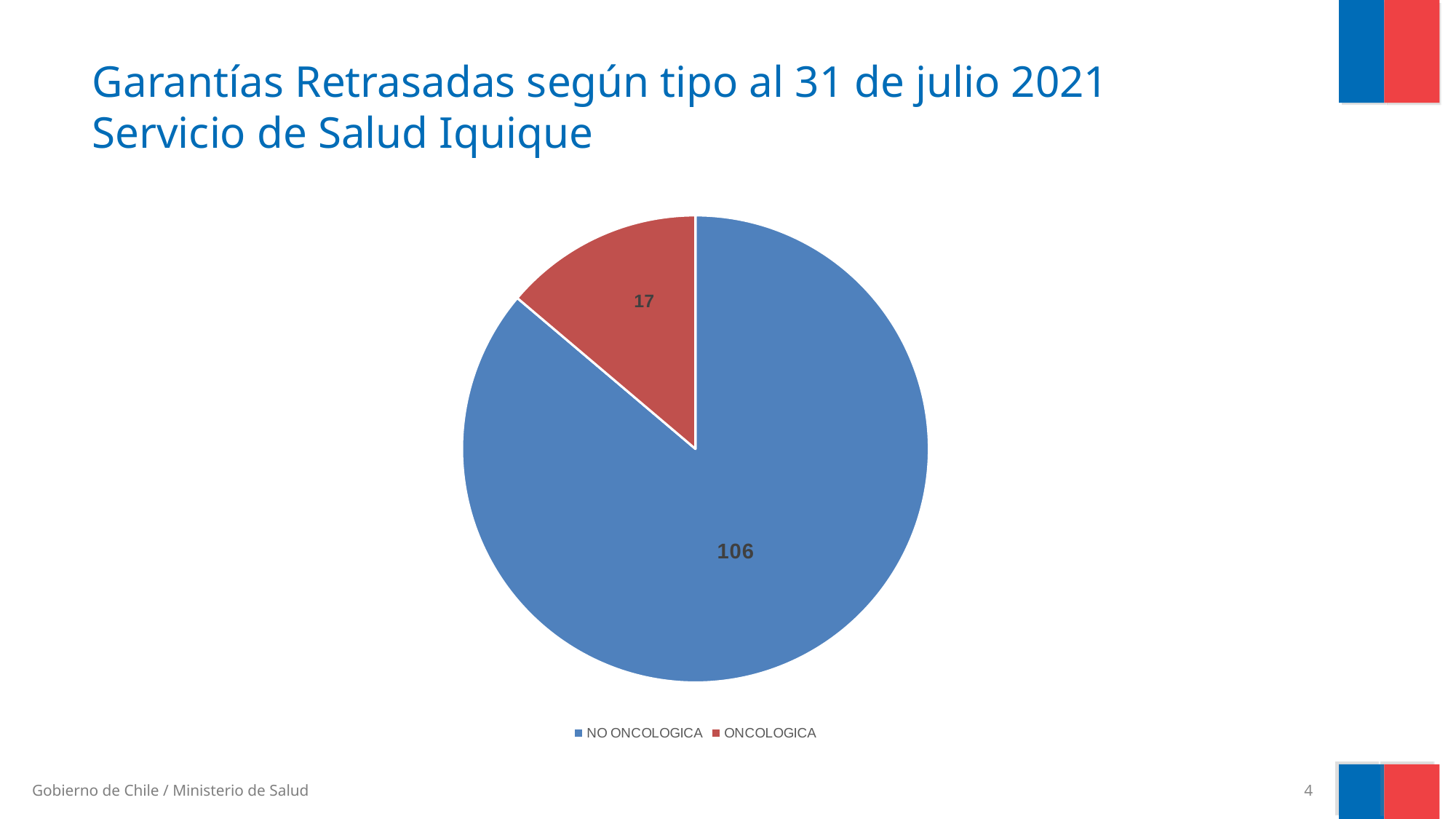
Which is larger, NO ONCOLOGICA or ONCOLOGICA? NO ONCOLOGICA How many slices does the pie chart have? 2 How many entries does the legend list? 2 What is the difference between the NO ONCOLOGICA and ONCOLOGICA values? 89 What is the value for NO ONCOLOGICA? 106 What is the total of all slices in the pie chart? 123 What colour is the ONCOLOGICA slice? red Which category has the smallest slice? ONCOLOGICA What is the value for ONCOLOGICA? 17 Which category has the largest slice? NO ONCOLOGICA What is the title of the slide containing the chart? Garantías Retrasadas según tipo al 31 de julio 2021 Servicio de Salud Iquique What type of chart is shown on the slide? pie chart